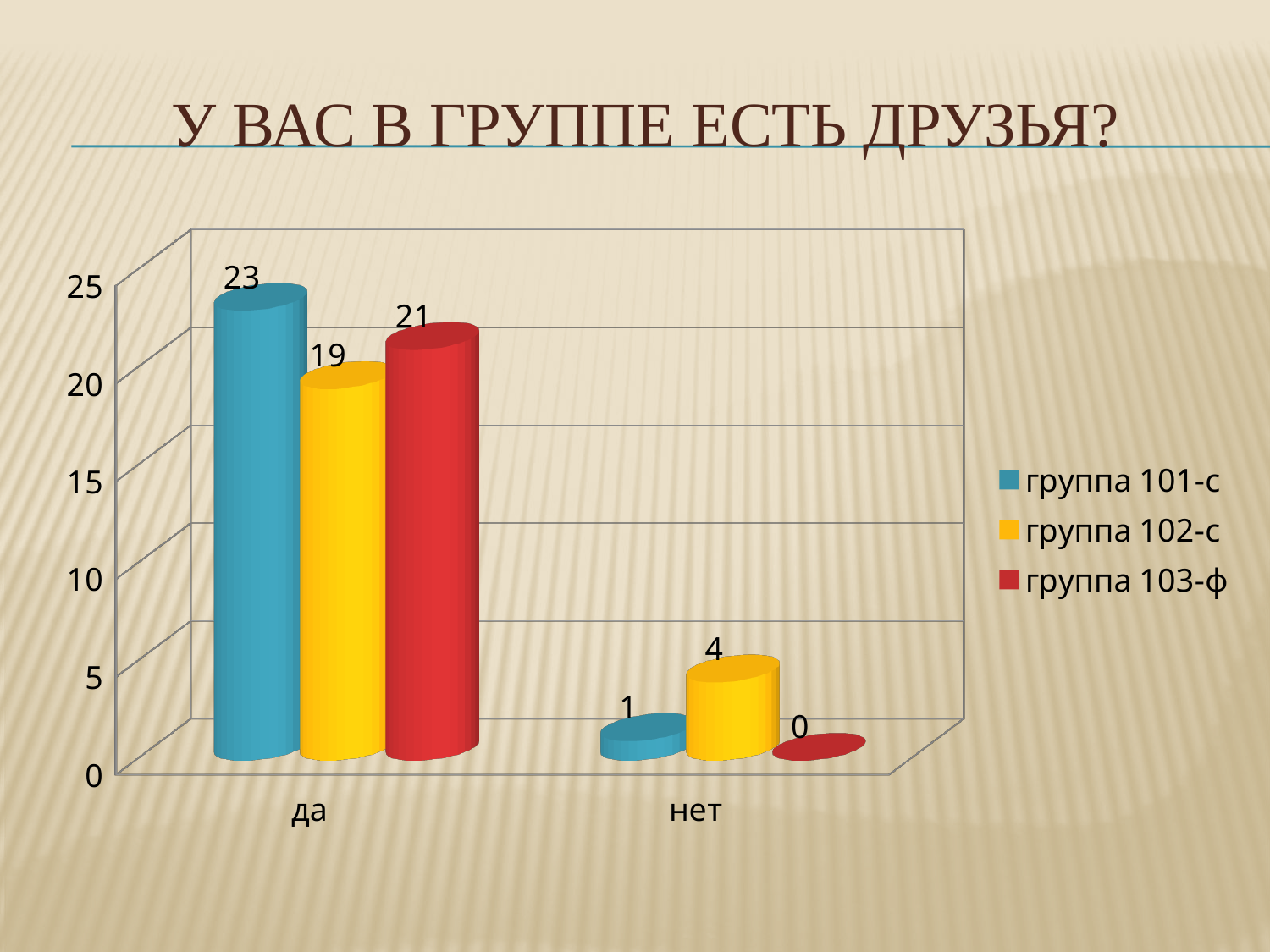
Which group has the highest value in the да category? группа 101-с What is the value for группа 103-ф in the нет category? 0 What is the difference between the да values for группа 101-с and группа 102-с? 4 What is the value for группа 102-с in the нет category? 4 What is the title of the slide? У ВАС В ГРУППЕ ЕСТЬ ДРУЗЬЯ? What is the value for группа 101-с in the да category? 23 How many series does the legend list? 3 What kind of chart is shown on the slide? bar chart What is the value for группа 102-с in the да category? 19 How many categories are shown on the x axis? 2 Which group has the lowest value in the нет category? группа 103-ф Which is larger: the да value for группа 103-ф or the да value for группа 102-с? группа 103-ф